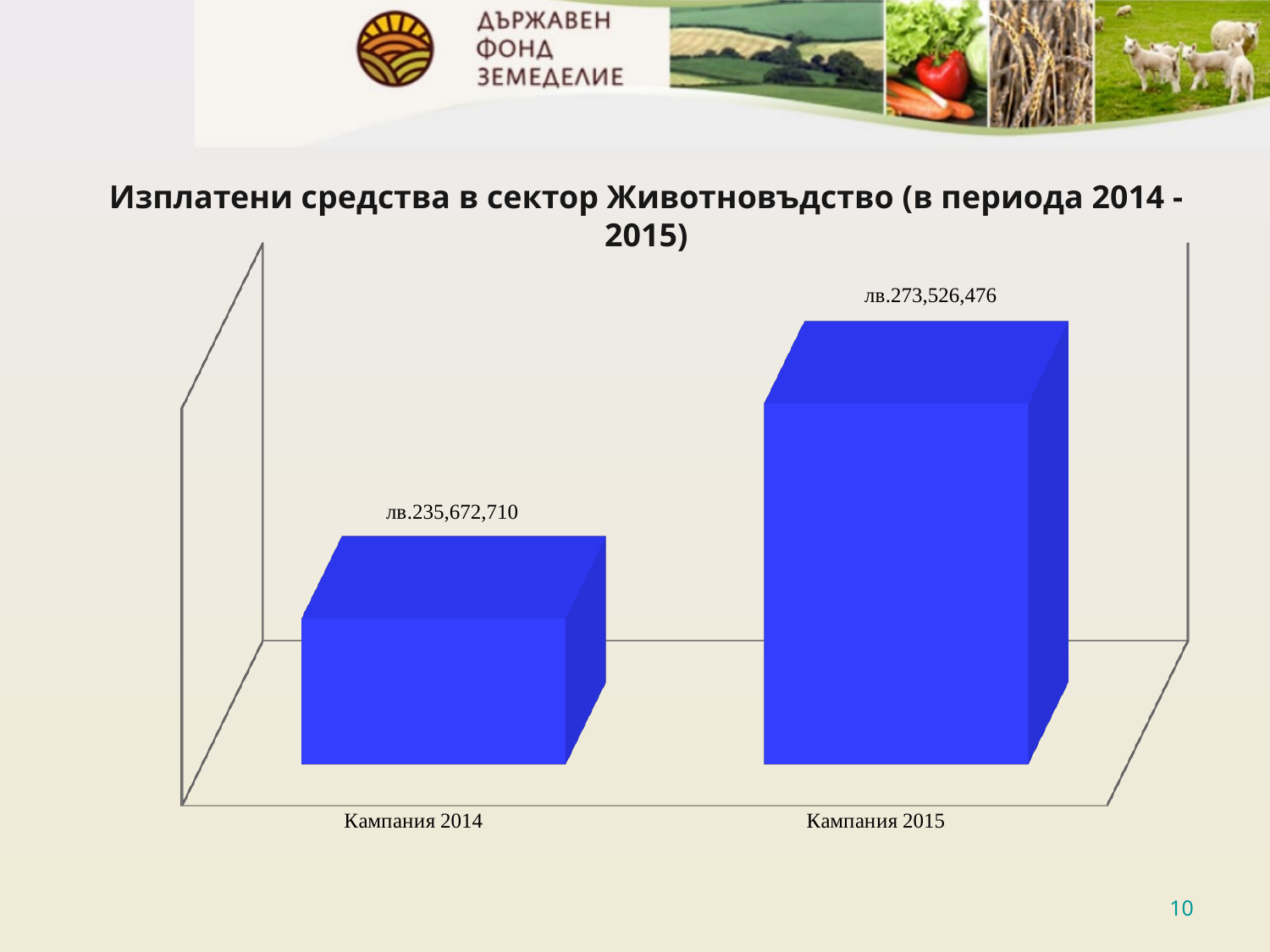
What is the difference between the values for Кампания 2015 and Кампания 2014? лв.37,853,766 Which category has the lowest value? Кампания 2014 Which is larger, the value for Кампания 2014 or Кампания 2015? Кампания 2015 What is the title of the chart? Изплатени средства в сектор Животновъдство (в периода 2014 - 2015) Which category has the highest value? Кампания 2015 What is the value for Кампания 2014? лв.235,672,710 What kind of chart is shown on the slide? Bar chart Do the values rise or fall from Кампания 2014 to Кампания 2015? Rise What colour are the bars in the chart? Blue What is the combined total of the two bars? лв.509,199,186 How many categories are shown on the chart? 2 What is the value for Кампания 2015? лв.273,526,476